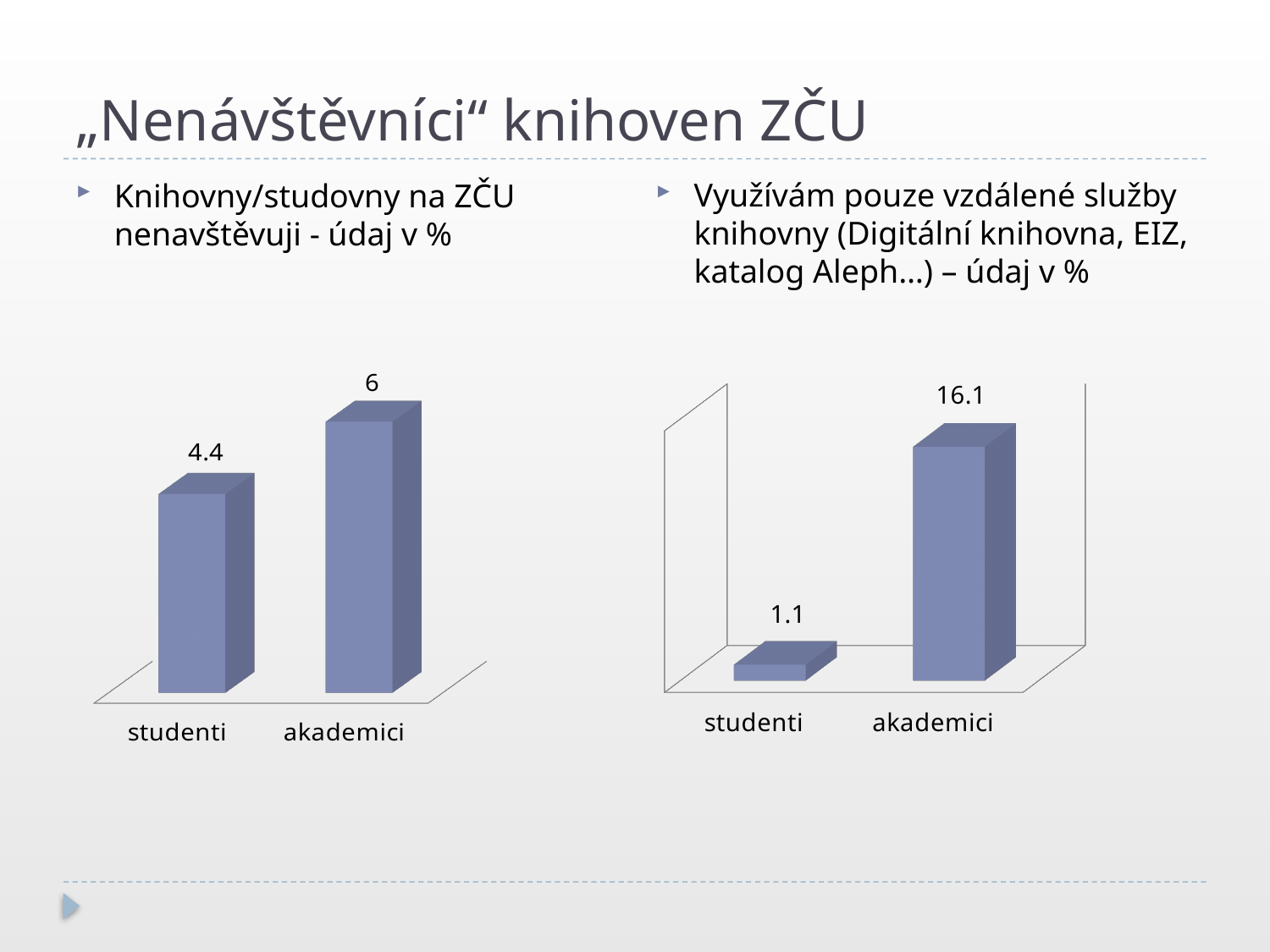
In the right chart, which category has the lowest value? studenti In the right chart, which is larger, the value for studenti or the value for akademici? akademici What is the title of the slide? „Nenávštěvníci“ knihoven ZČU In the left chart, what is the difference between the values for akademici and studenti? 1.6 In the right chart, what is the value for studenti? 1.1 What kind of chart is the right chart? bar chart In the left chart, which category has the highest value? akademici In the left chart, what is the value for studenti? 4.4 In the right chart, what is the difference between the values for akademici and studenti? 15 In the left chart, what is the value for akademici? 6 How many categories does the left chart show? 2 In the right chart, what is the value for akademici? 16.1